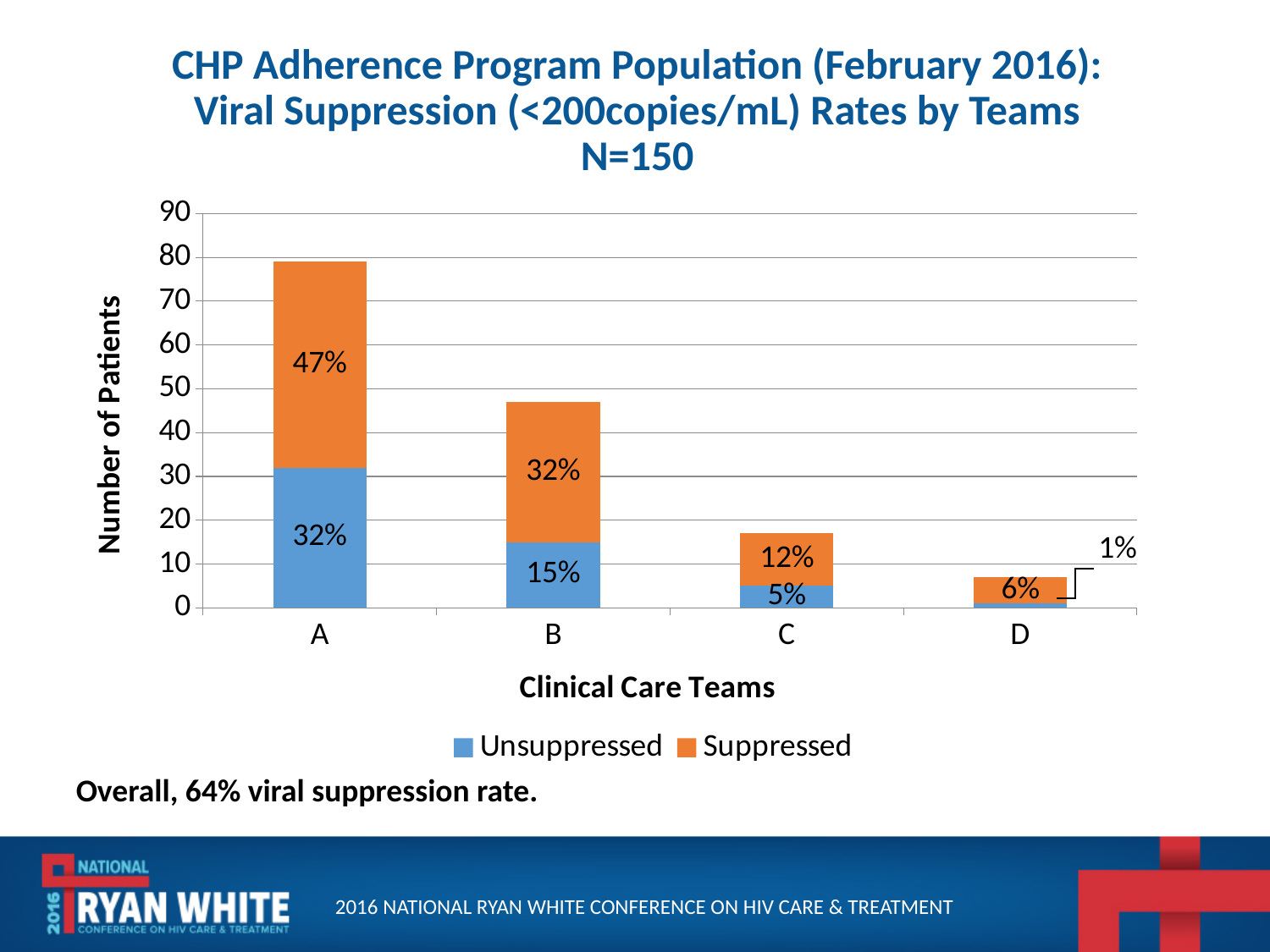
What is the difference between the Suppressed labels for Team A and Team B? 15% How many series does the legend list? 2 Which clinical care team has the tallest stacked bar? A Is the total height of the stacked bar for Team A greater or less than 70 patients? greater What is the Unsuppressed label shown for Team D? 1% Do the stacked bar heights rise or fall from Team A to Team D? Fall What is the Unsuppressed label shown for Team B? 15% Which clinical care team has the shortest stacked bar? D What is the Suppressed label shown for Team A? 47% What is the Suppressed label shown for Team C? 12% What kind of chart is shown on the slide? Stacked bar chart How many clinical care teams are shown on the x axis? 4